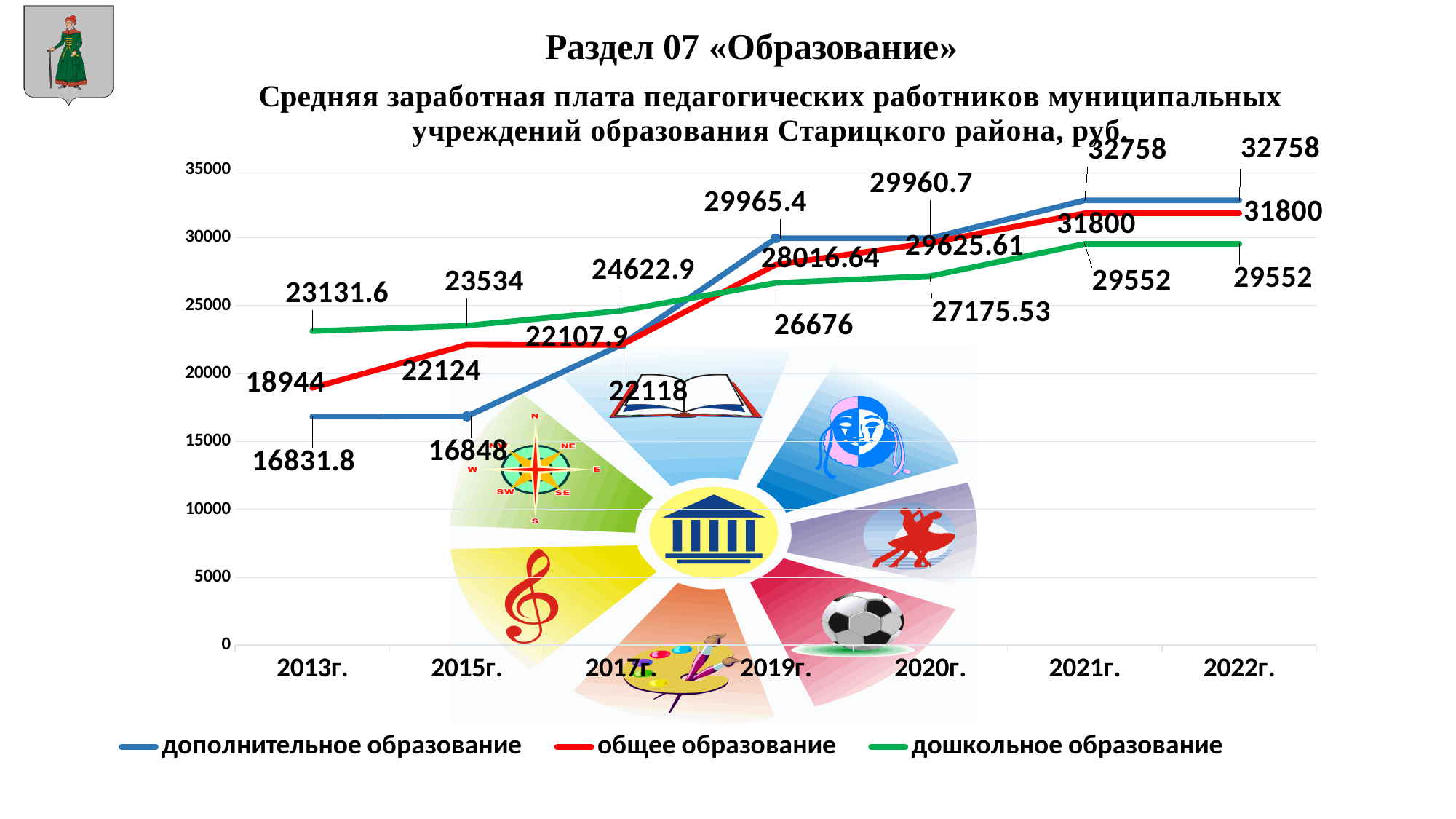
What is the value for дошкольное образование in 2017г.? 24622.9 What is the value for дополнительное образование in 2019г.? 29965.4 What is the value for дошкольное образование in 2020г.? 27175.53 What is the value for общее образование in 2013г.? 18944 What kind of chart is shown on the slide? line chart What is the difference between дополнительное образование and общее образование in 2022г.? 958 How many years are shown on the x axis? 7 Which series has the highest value in 2013г.? дошкольное образование In 2019г., which is larger: дополнительное образование or общее образование? дополнительное образование In which year is the value for общее образование lowest? 2013г. What is the difference between дошкольное образование and дополнительное образование in 2013г.? 6299.8 How many series does the legend list? 3